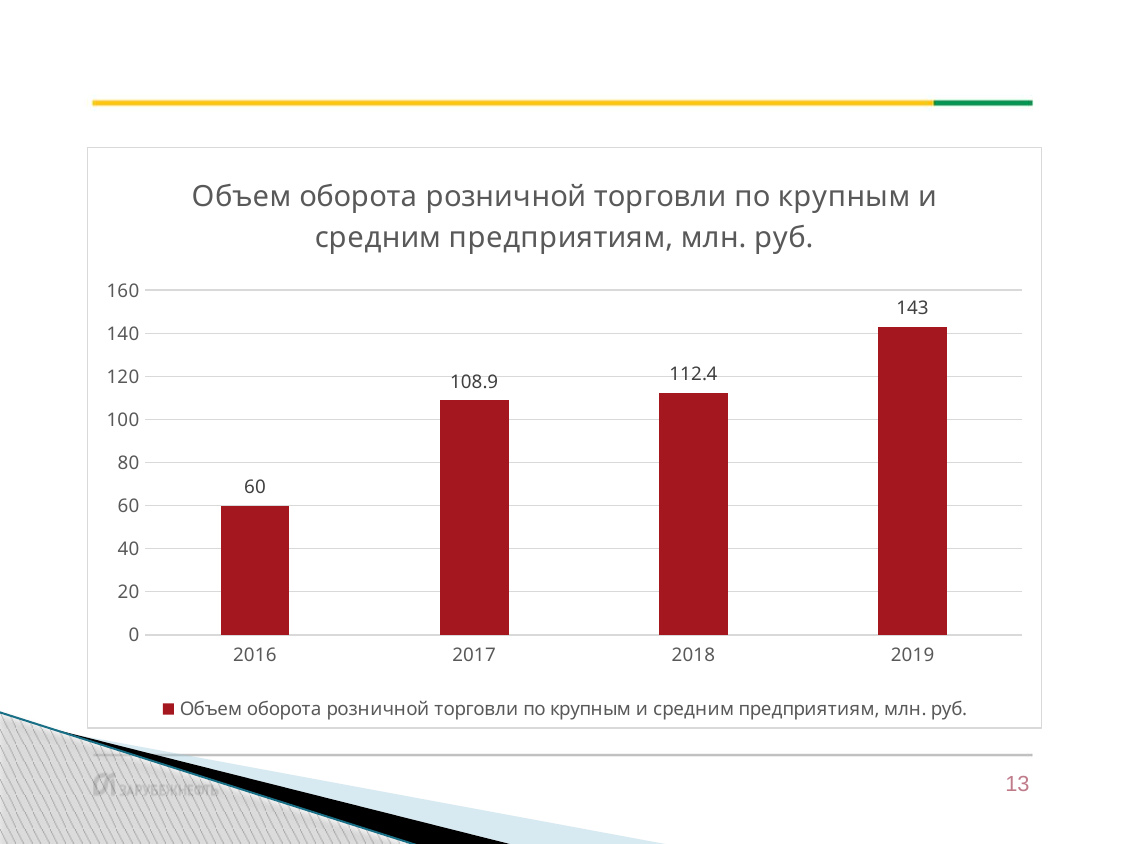
Which year has the lowest value? 2016 Do the values rise or fall from 2016 to 2019? rise What is the difference between the values for 2018 and 2017? 3.5 What is the value for 2016? 60 What is the value for 2019? 143 How many years are shown on the x axis? 4 What kind of chart is this? bar chart Which year has the highest value? 2019 What is the value for 2018? 112.4 What is the difference between the values for 2019 and 2016? 83 Which is larger, the value for 2017 or the value for 2019? 2019 What is the value for 2017? 108.9